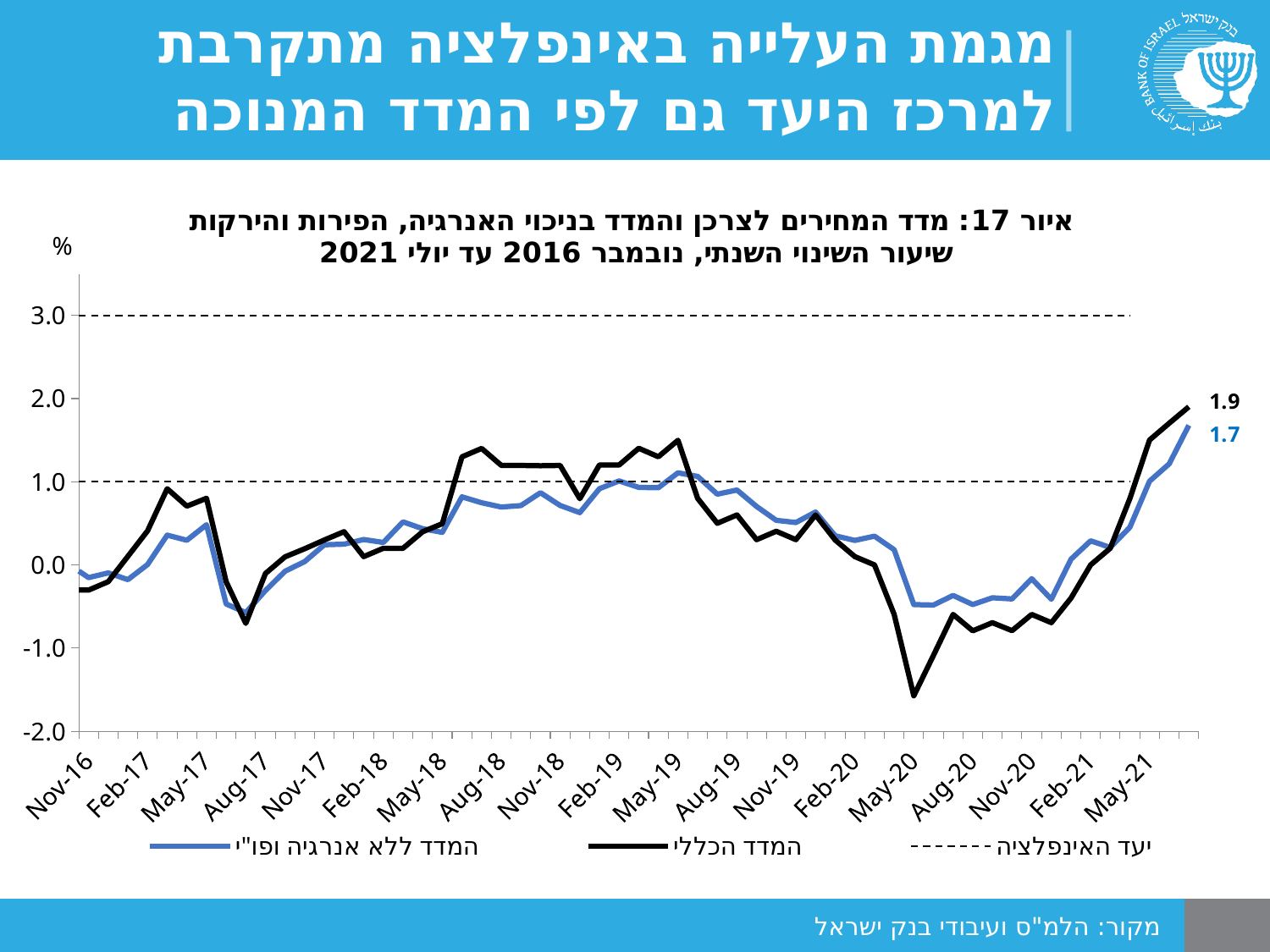
Is the value of the blue line (המדד ללא אנרגיה ופו"י) at Aug-20 greater or less than -1.0? greater What kind of chart is shown on the slide? line chart In which year does the black line (המדד הכללי) reach its lowest point? 2020 What is the last labelled value of the series המדד ללא אנרגיה ופו"י (the blue line)? 1.7 What is the difference between the final labelled values of המדד הכללי and המדד ללא אנרגיה ופו"י? 0.2 Is the lowest value of the black line (המדד הכללי), reached around May-20, greater or less than -1.0? less What unit is shown on the y axis? % At which two levels are the dashed lines for יעד האינפלציה drawn? 1.0 and 3.0 At the end of the period, which series is higher: המדד הכללי or המדד ללא אנרגיה ופו"י? המדד הכללי What is the last labelled value of the series המדד הכללי (the black line)? 1.9 How many entries does the legend list? 3 Do the two plotted series rise or fall between Feb-21 and the end of the chart? rise